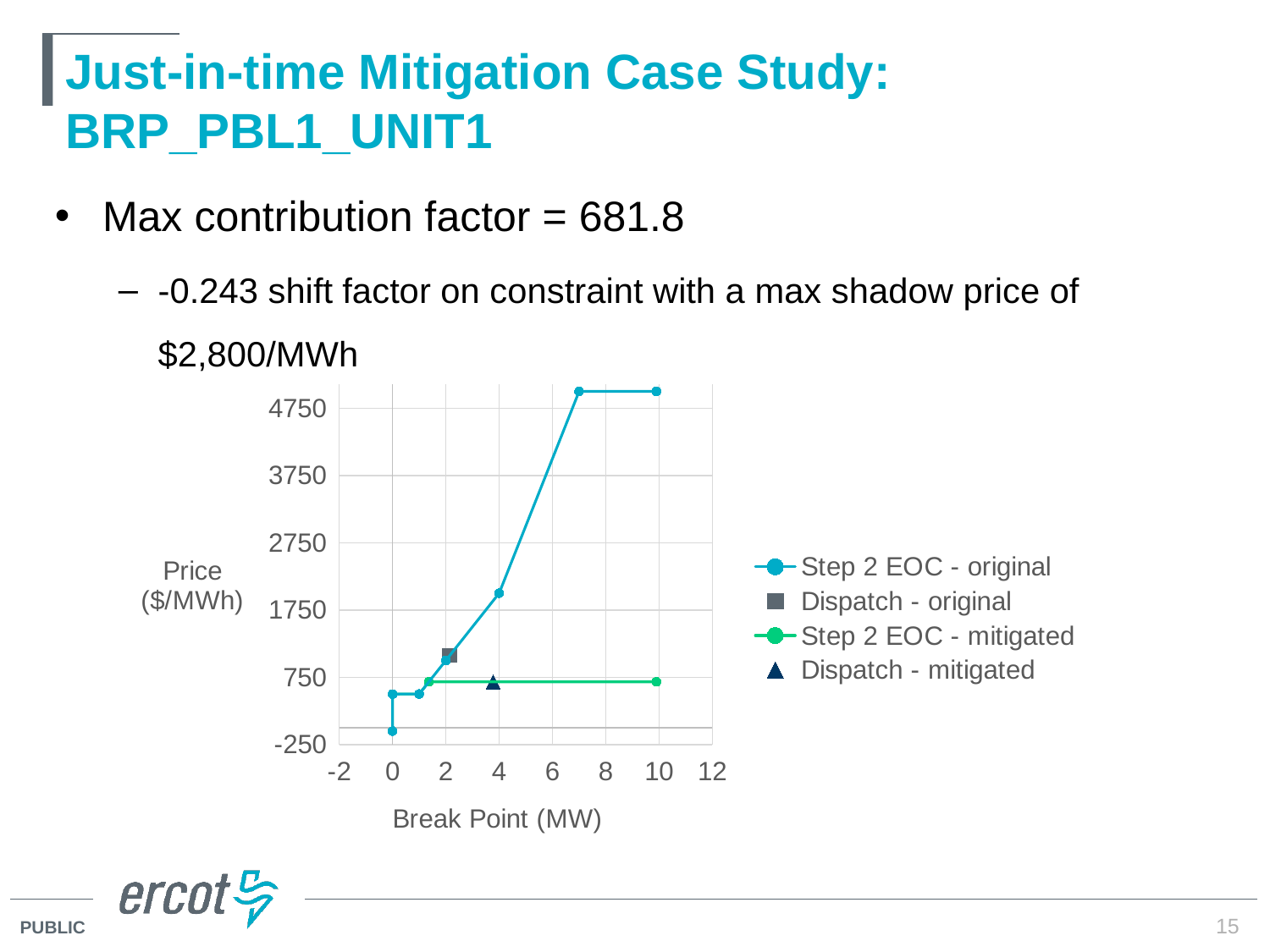
Is the value of the Step 2 EOC - original series at a break point of 4 MW greater or less than 1750? greater What kind of chart is shown on the slide? line chart Is the price of the Dispatch - original point greater or less than 1750? less Is the price of the Dispatch - original point greater or less than 750? greater At a break point of 10 MW, which series has the higher price: Step 2 EOC - original or Step 2 EOC - mitigated? Step 2 EOC - original How many series does the chart legend list? 4 Does the Step 2 EOC - original series generally rise or fall as the break point increases? rise What is the title of the x axis of the chart? Break Point (MW) Which has the higher price: the Dispatch - original point or the Dispatch - mitigated point? Dispatch - original What is the title of the y axis of the chart? Price ($/MWh)